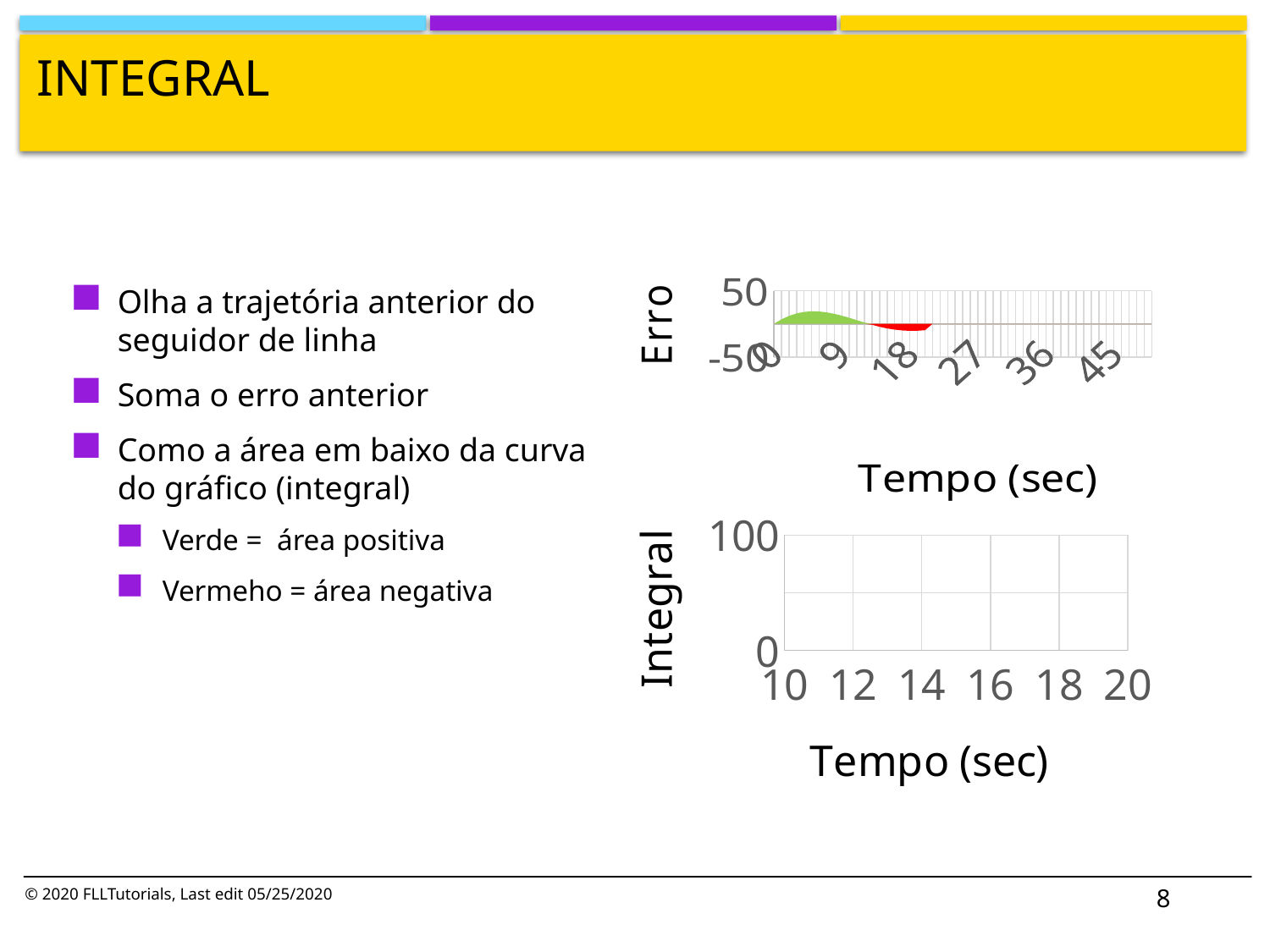
In the bottom Integral chart, how many tick labels are shown on the x axis? 6 What is the x-axis title of the bottom Integral chart? Tempo (sec) In the top Erro chart, what colour is the area above zero? green In the top Erro chart, how many tick labels are shown on the x axis? 6 In the bottom Integral chart, what is the highest value shown on the y axis? 100 What kind of chart is the top chart labelled Erro? area chart